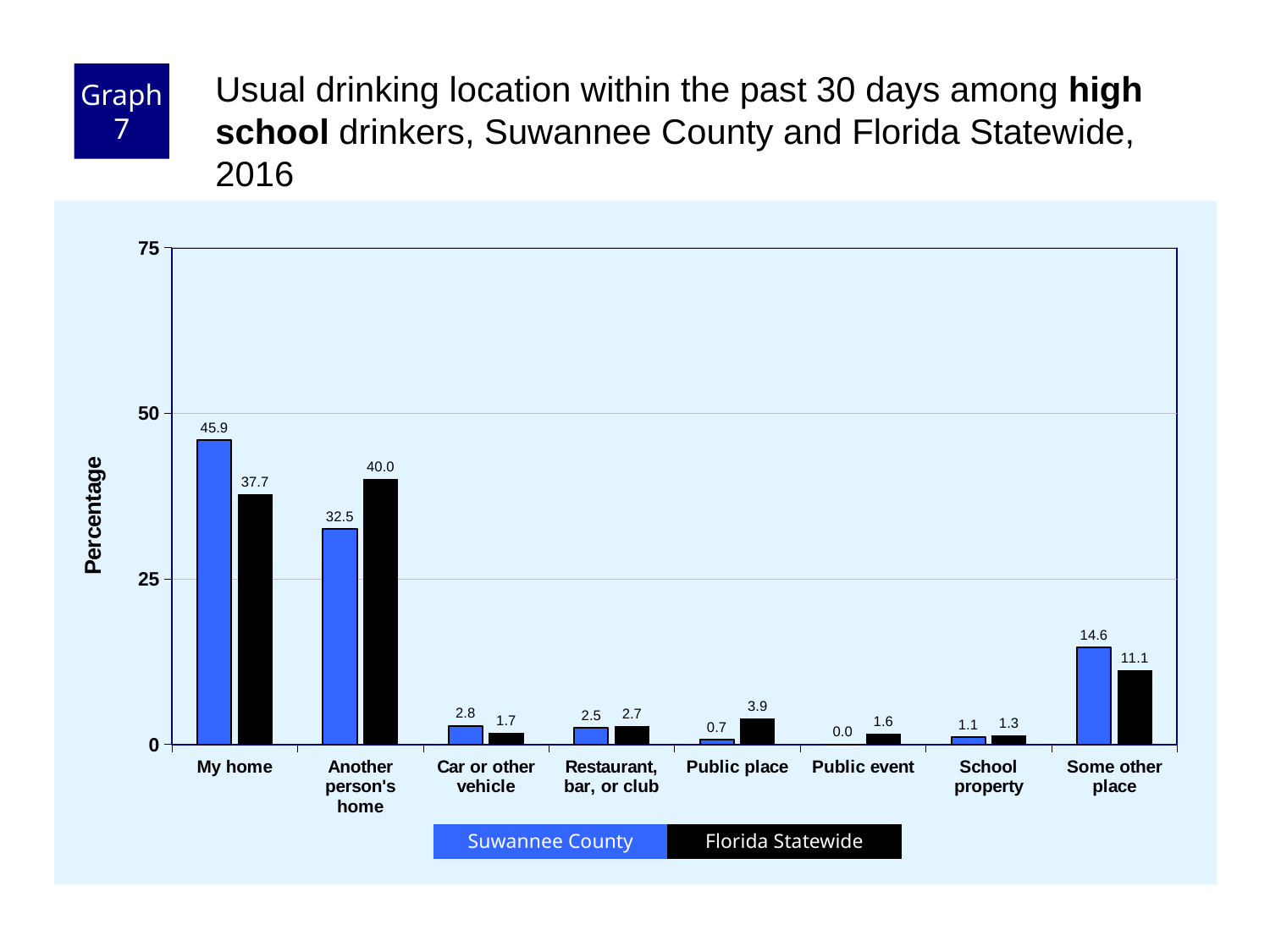
For Public place, which is larger: the Suwannee County value or the Florida Statewide value? Florida Statewide Which category has the highest Suwannee County value? My home What is the Florida Statewide value for Some other place? 11.1 How many categories are shown on the x axis? 8 What is the Suwannee County value for My home? 45.9 Is the Suwannee County value for Another person's home greater or less than 25? greater How many series does the legend list? 2 What is the Suwannee County value for Public event? 0.0 What is the difference between the Suwannee County and Florida Statewide values for My home? 8.2 Which category has the lowest Florida Statewide value? School property What kind of chart is shown on the slide? Bar chart What is the Florida Statewide value for Another person's home? 40.0